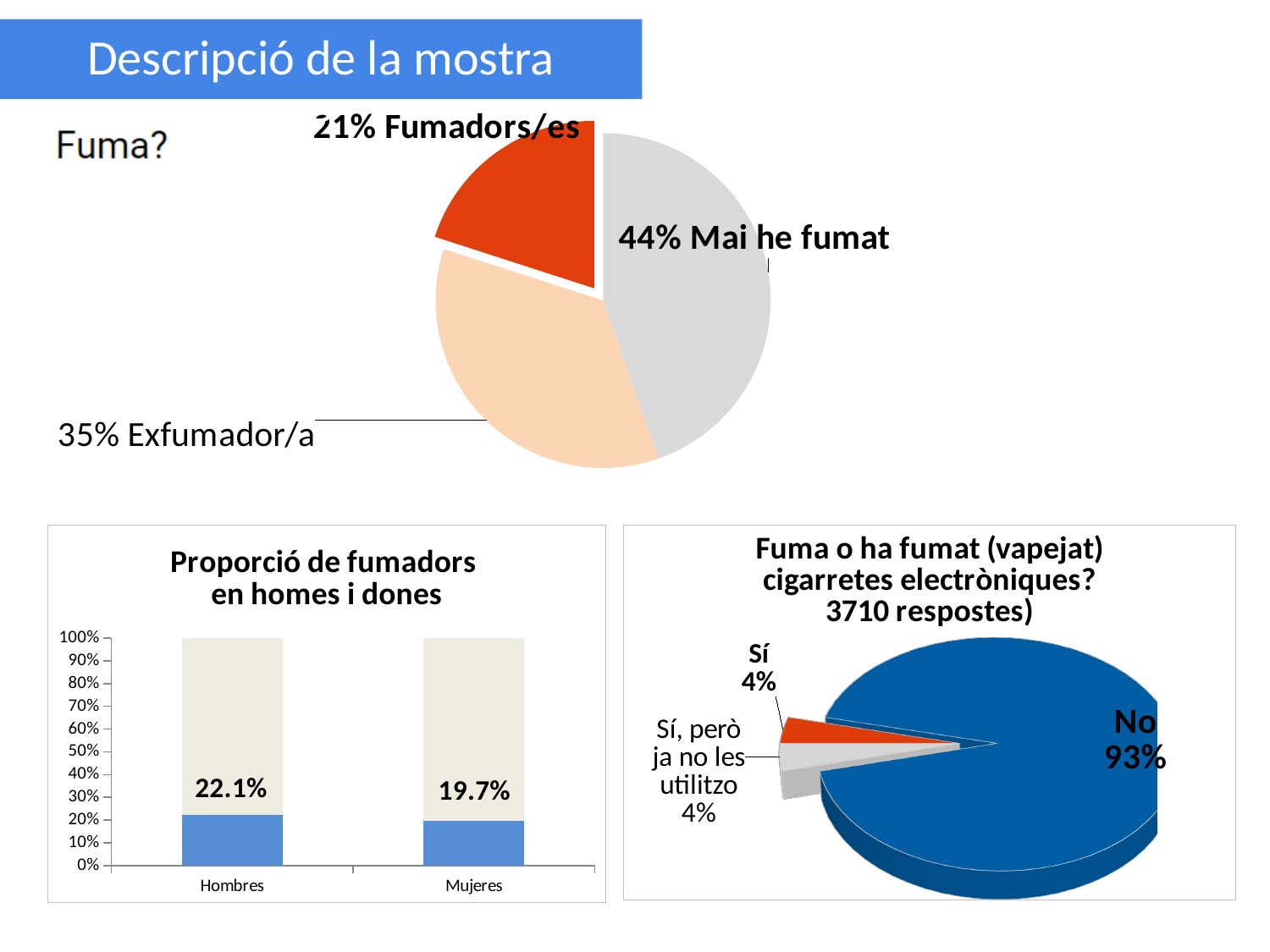
What kind of chart is 'Proporció de fumadors en homes i dones'? bar chart In the 'Proporció de fumadors en homes i dones' chart, what is the value for Hombres? 22.1% In the top 'Fuma?' pie chart, what percentage is labelled 'Mai he fumat'? 44% In the top 'Fuma?' pie chart, how many slices are there? 3 In the top 'Fuma?' pie chart, what percentage is labelled 'Exfumador/a'? 35% In the 'Fuma o ha fumat (vapejat) cigarretes electròniques?' pie chart, how many responses does the title state? 3710 respostes In the top 'Fuma?' pie chart, which category has the smallest share? Fumadors/es In the 'Fuma o ha fumat (vapejat) cigarretes electròniques?' pie chart, what percentage answered 'No'? 93% In the 'Proporció de fumadors en homes i dones' chart, what is the difference between the Hombres and Mujeres values? 2.4% In the top 'Fuma?' pie chart, what is the difference between the 'Mai he fumat' share and the 'Fumadors/es' share? 23% In the 'Proporció de fumadors en homes i dones' chart, what is the value for Mujeres? 19.7% In the top 'Fuma?' pie chart, which category has the largest share? Mai he fumat